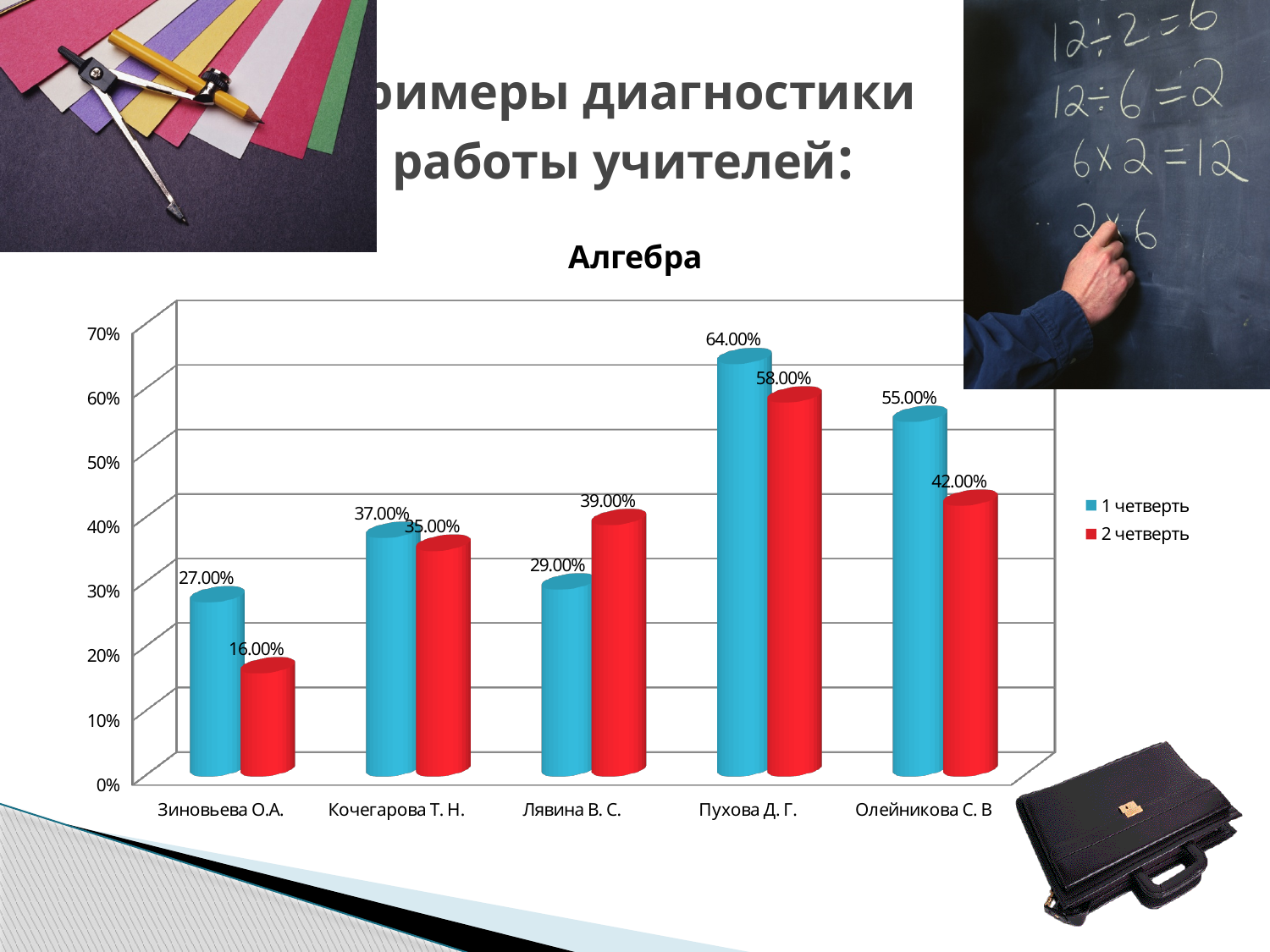
What is the title of the chart? Алгебра What is the difference between the 1 четверть and 2 четверть values for Олейникова С. В? 13.00% Which teacher has the lowest value in the 2 четверть series? Зиновьева О.А. What is the value for Лявина В. С. in the 2 четверть series? 39.00% What is the value for Зиновьева О.А. in the 1 четверть series? 27.00% For Лявина В. С., which series has the larger value, 1 четверть or 2 четверть? 2 четверть How many series does the legend list? 2 What is the value for Олейникова С. В in the 2 четверть series? 42.00% Which teacher has the highest value in the 1 четверть series? Пухова Д. Г. How many teachers are shown on the x axis of the chart? 5 What kind of chart is shown on the slide? Bar chart Is the 1 четверть value for Пухова Д. Г. greater or less than 60%? greater